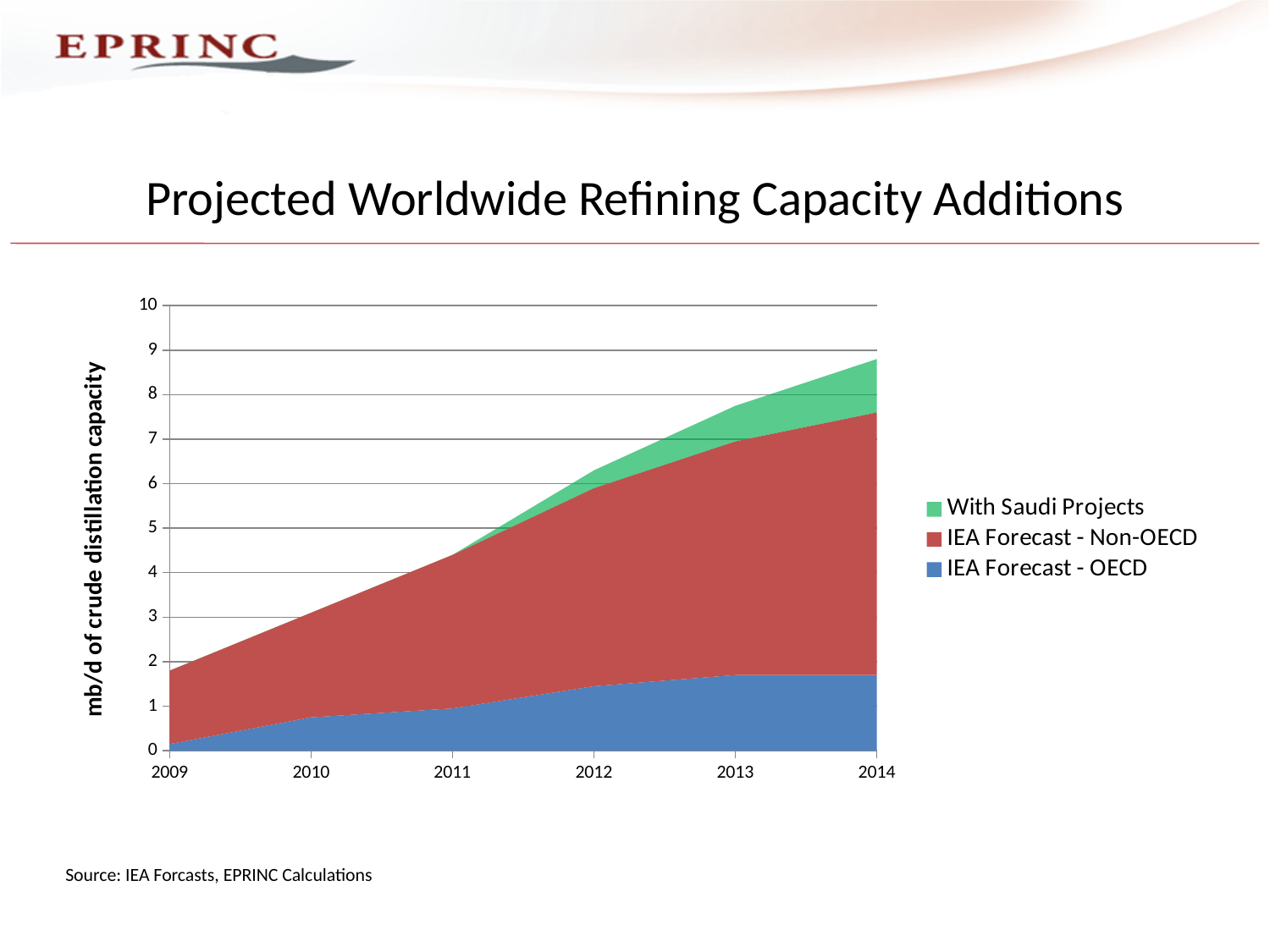
Is the total stacked value for 2011 greater or less than 5? less What kind of chart is shown on the slide? Stacked area chart How many series does the legend list? 3 How many years are shown along the x axis? 6 Is the total stacked value for 2014 greater or less than 8? greater Is the value for IEA Forecast - OECD in 2014 greater or less than 2? less Does the total projected refining capacity addition rise or fall from 2009 to 2014? Rise In which year is the total stacked value lowest? 2009 In which year is the total stacked value highest? 2014 Which series is shown in green? With Saudi Projects What is the label on the y axis? mb/d of crude distillation capacity